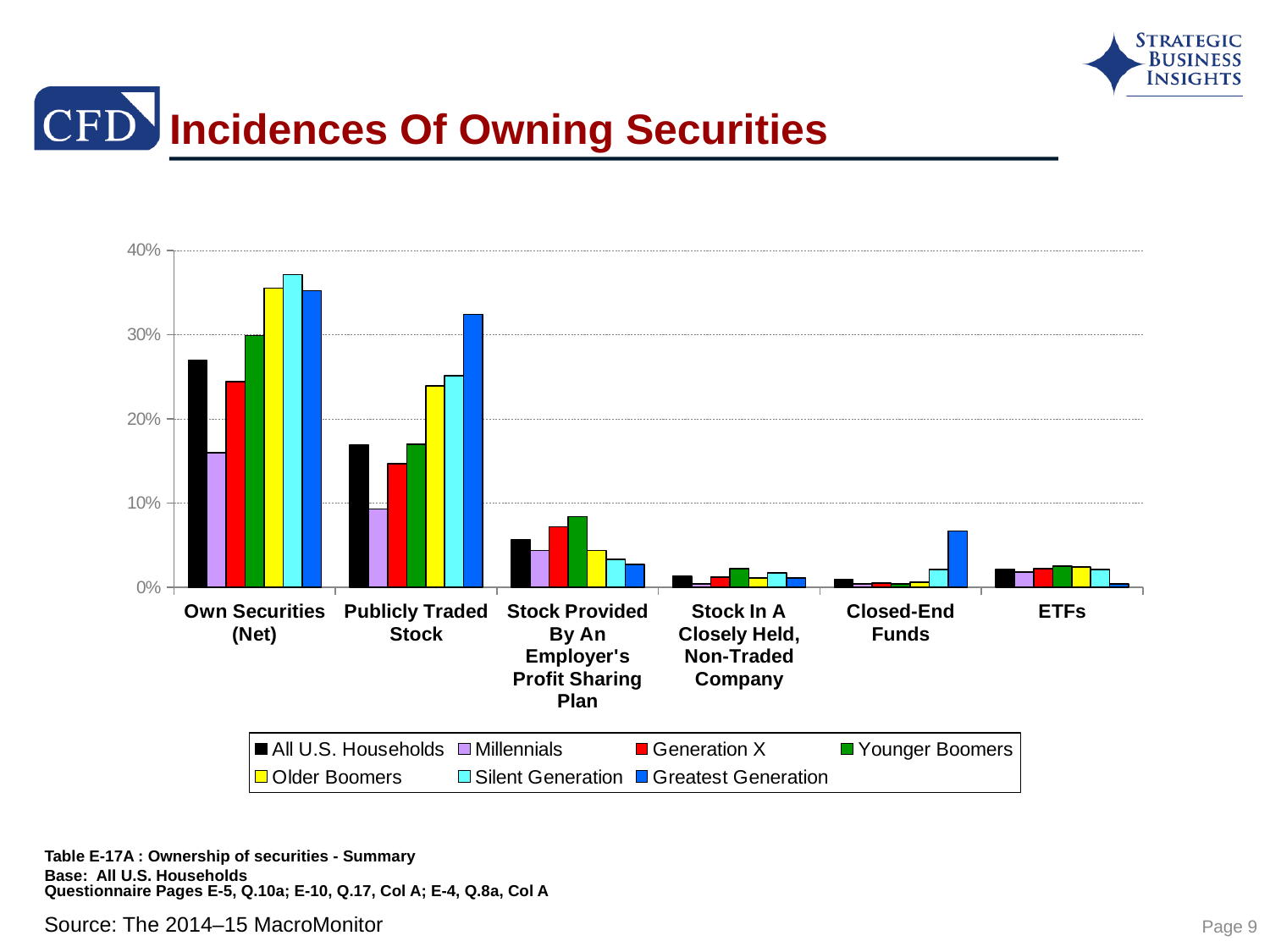
Is the value for All U.S. Households in the Own Securities (Net) category greater or less than 20%? greater Is the value for Millennials in the Own Securities (Net) category greater or less than 20%? less How many series does the legend list? 7 In the Stock Provided By An Employer's Profit Sharing Plan category, which is larger: Younger Boomers or Greatest Generation? Younger Boomers Which series has the lowest value in the Own Securities (Net) category? Millennials How many categories are shown along the x axis? 6 What kind of chart is shown on the slide? bar chart What is the title of the chart? Incidences Of Owning Securities Is the value for Greatest Generation in the Publicly Traded Stock category greater or less than 30%? greater Which series has the highest value in the Closed-End Funds category? Greatest Generation Which category has the highest values overall? Own Securities (Net) Which series has the highest value in the Publicly Traded Stock category? Greatest Generation